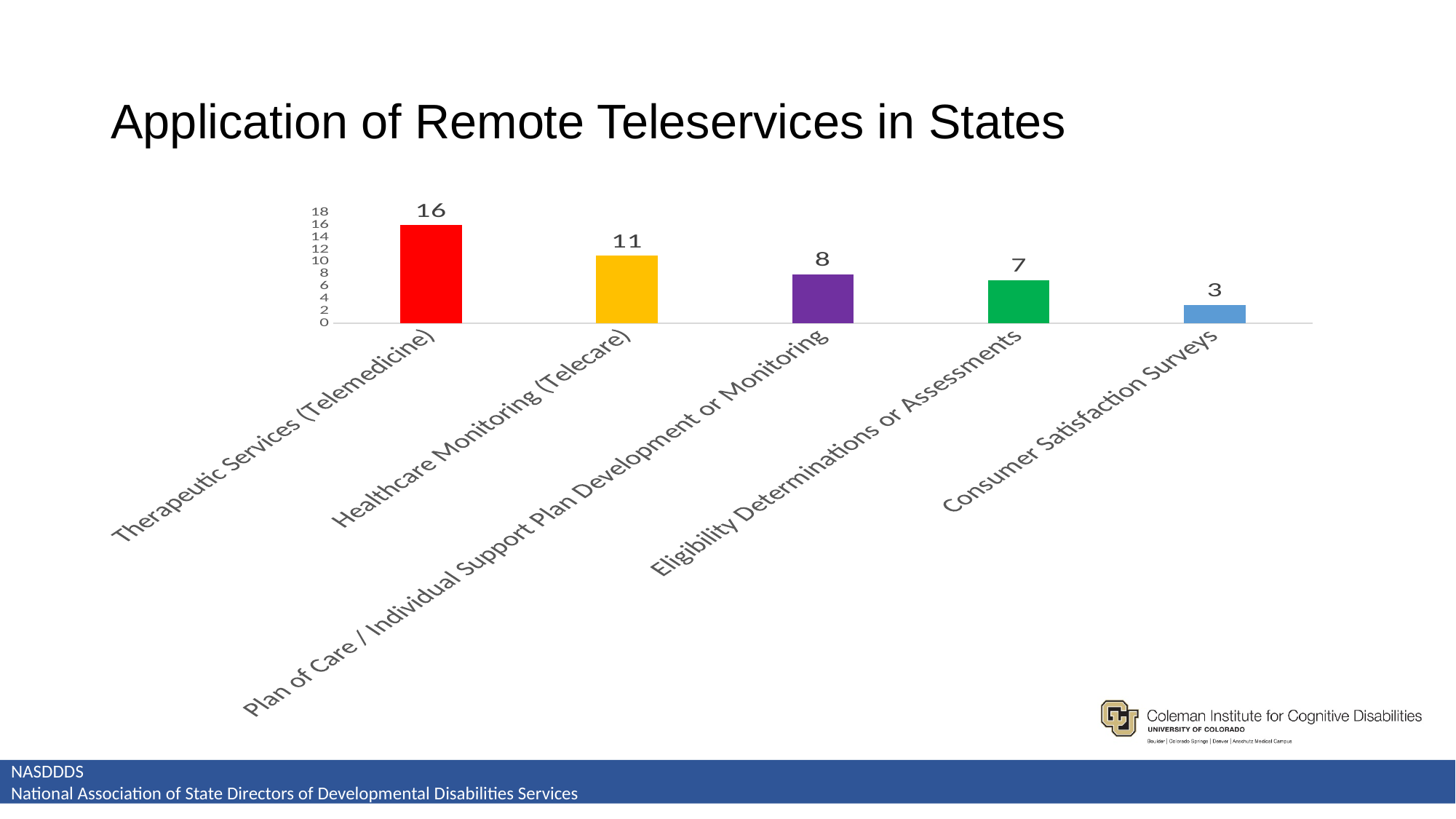
Which category has the highest value? Therapeutic Services (Telemedicine) Which category has the lowest value? Consumer Satisfaction Surveys What is the value for Healthcare Monitoring (Telecare)? 11 What is the value for Consumer Satisfaction Surveys? 3 Do the values rise or fall from left to right across the categories? Fall What kind of chart is shown on the slide? Bar chart What is the value for Therapeutic Services (Telemedicine)? 16 What is the value for Plan of Care / Individual Support Plan Development or Monitoring? 8 How many categories are shown in the chart? 5 What is the difference between the values for Eligibility Determinations or Assessments and Consumer Satisfaction Surveys? 4 What is the difference between the values for Therapeutic Services (Telemedicine) and Healthcare Monitoring (Telecare)? 5 Which is larger, the value for Healthcare Monitoring (Telecare) or the value for Eligibility Determinations or Assessments? Healthcare Monitoring (Telecare)